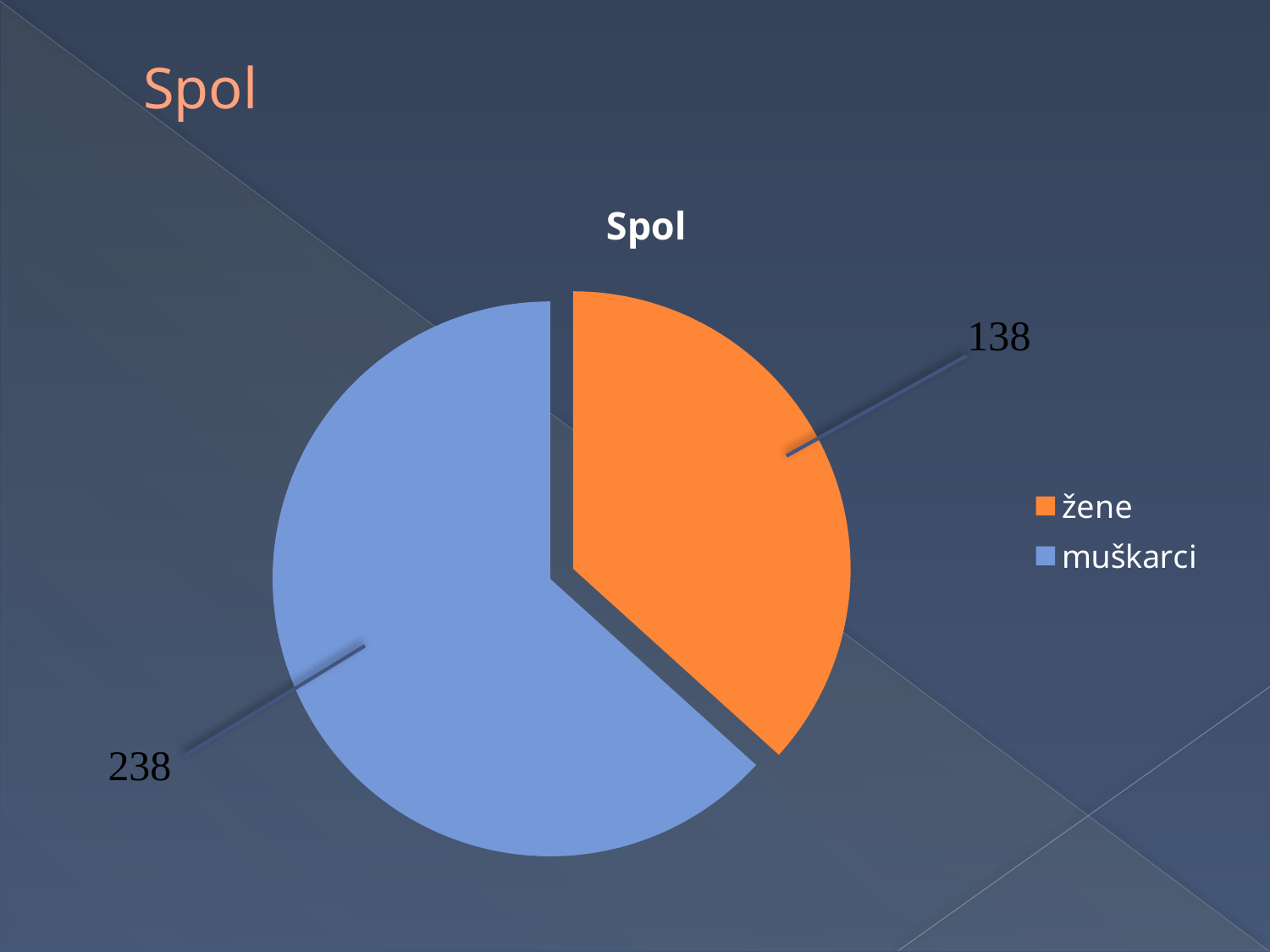
Which category has the smallest slice of the pie? žene How many entries does the legend list? 2 What kind of chart is shown on the slide? pie chart What is the total of all slices in the pie chart? 376 Which is larger, the value for žene or the value for muškarci? muškarci What is the value for muškarci? 238 What is the title of the chart? Spol Which colour represents žene in the pie chart? orange What is the value for žene? 138 What is the difference between the values for muškarci and žene? 100 Which category has the largest slice of the pie? muškarci How many categories does the pie chart have? 2